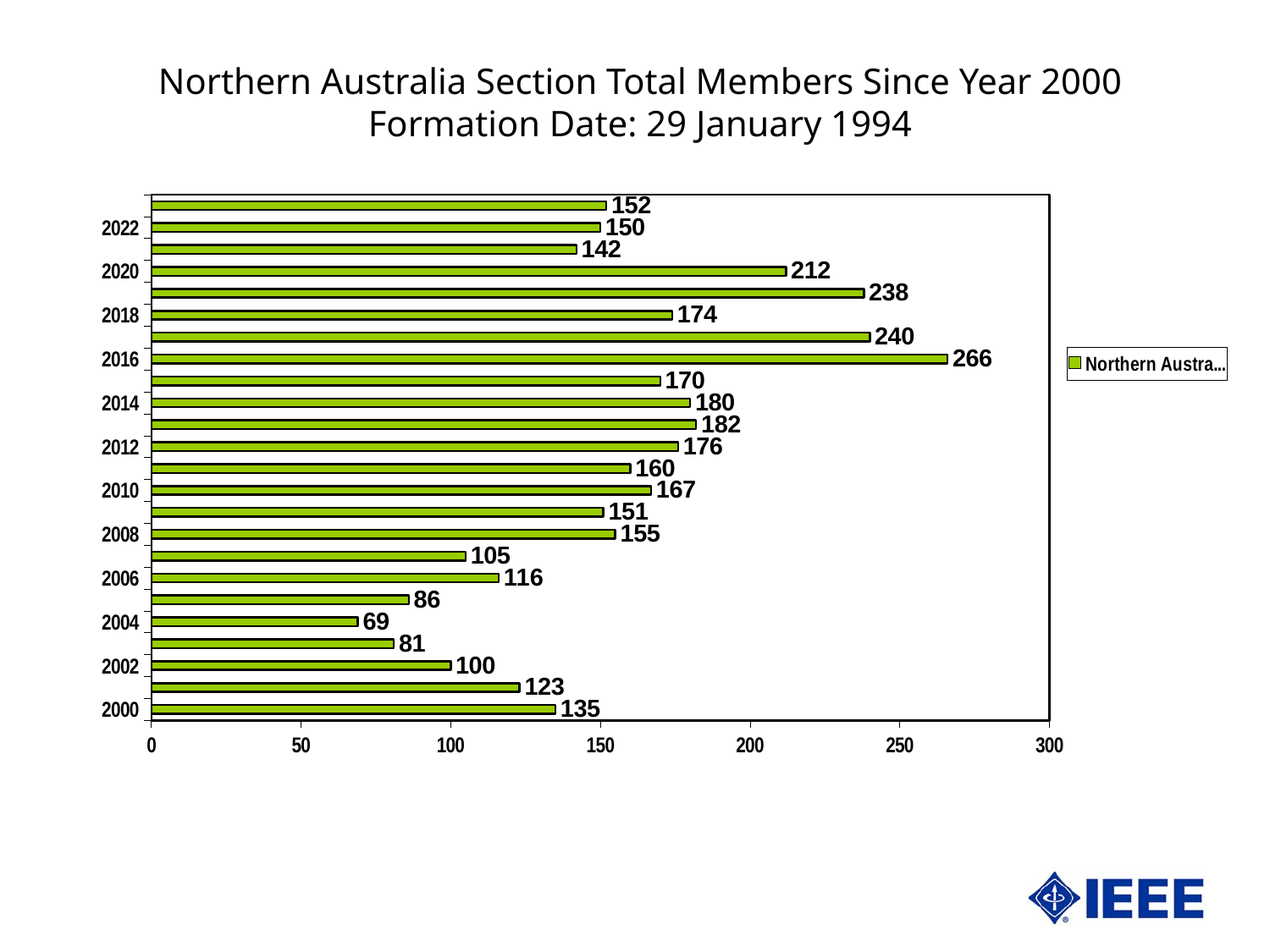
What is the value for 2004? 69 What type of chart is shown on the slide? bar chart What is the value for 2000? 135 What is the difference between the values for 2016 and 2018? 92 How many bars are plotted in the chart? 24 What is the title of the chart? Northern Australia Section Total Members Since Year 2000 Formation Date: 29 January 1994 Which year has the lowest value? 2004 Which year has the highest value? 2016 Is the value for 2012 greater or less than 150? greater Which is larger, the value for 2002 or the value for 2006? 2006 What is the value for 2016? 266 What is the value for 2020? 212